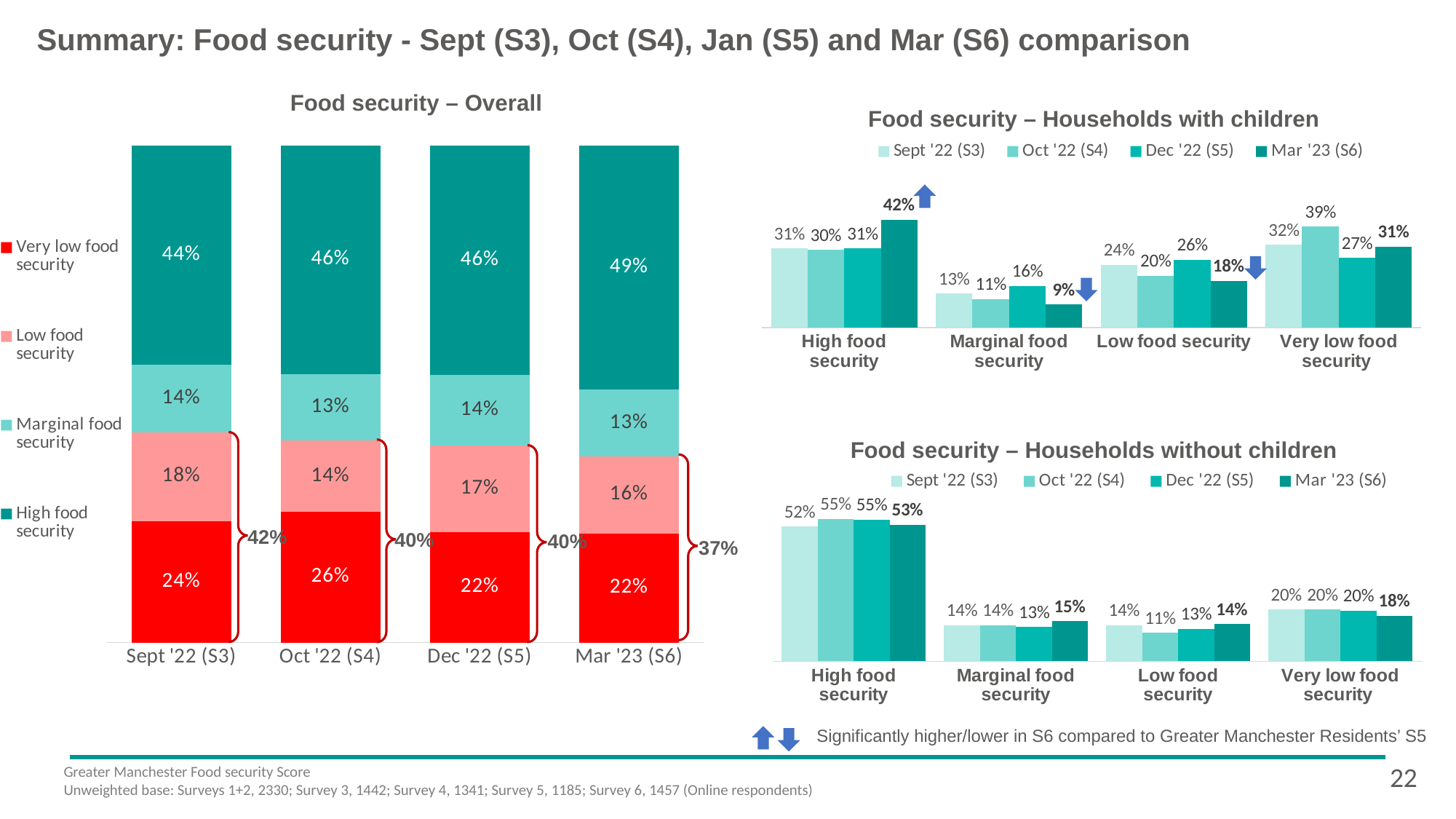
In the 'Food security – Overall' chart, which survey wave has the highest high food security value? Mar '23 (S6) How many categories are shown on the x axis of the 'Food security – Households without children' chart? 4 In the 'Food security – Households without children' chart, is the high food security value for Sept '22 (S3) or Oct '22 (S4) larger? Oct '22 (S4) In the 'Food security – Households with children' chart, which survey wave has the highest very low food security value? Oct '22 (S4) In the 'Food security – Households with children' chart, which survey wave has the lowest marginal food security value? Mar '23 (S6) In the 'Food security – Overall' chart, what is the very low food security value for Oct '22 (S4)? 26% In the 'Food security – Overall' chart, what is the difference between the low food security values for Sept '22 (S3) and Oct '22 (S4)? 4% In the 'Food security – Households without children' chart, what is the low food security value for Oct '22 (S4)? 11% In the 'Food security – Overall' chart, what percentage of respondents had high food security in Mar '23 (S6)? 49% What type of chart is 'Food security – Overall'? Stacked bar chart In the 'Food security – Households with children' chart, what is the high food security value for Mar '23 (S6)? 42% In the 'Food security – Overall' chart, how many series does the legend list? 4